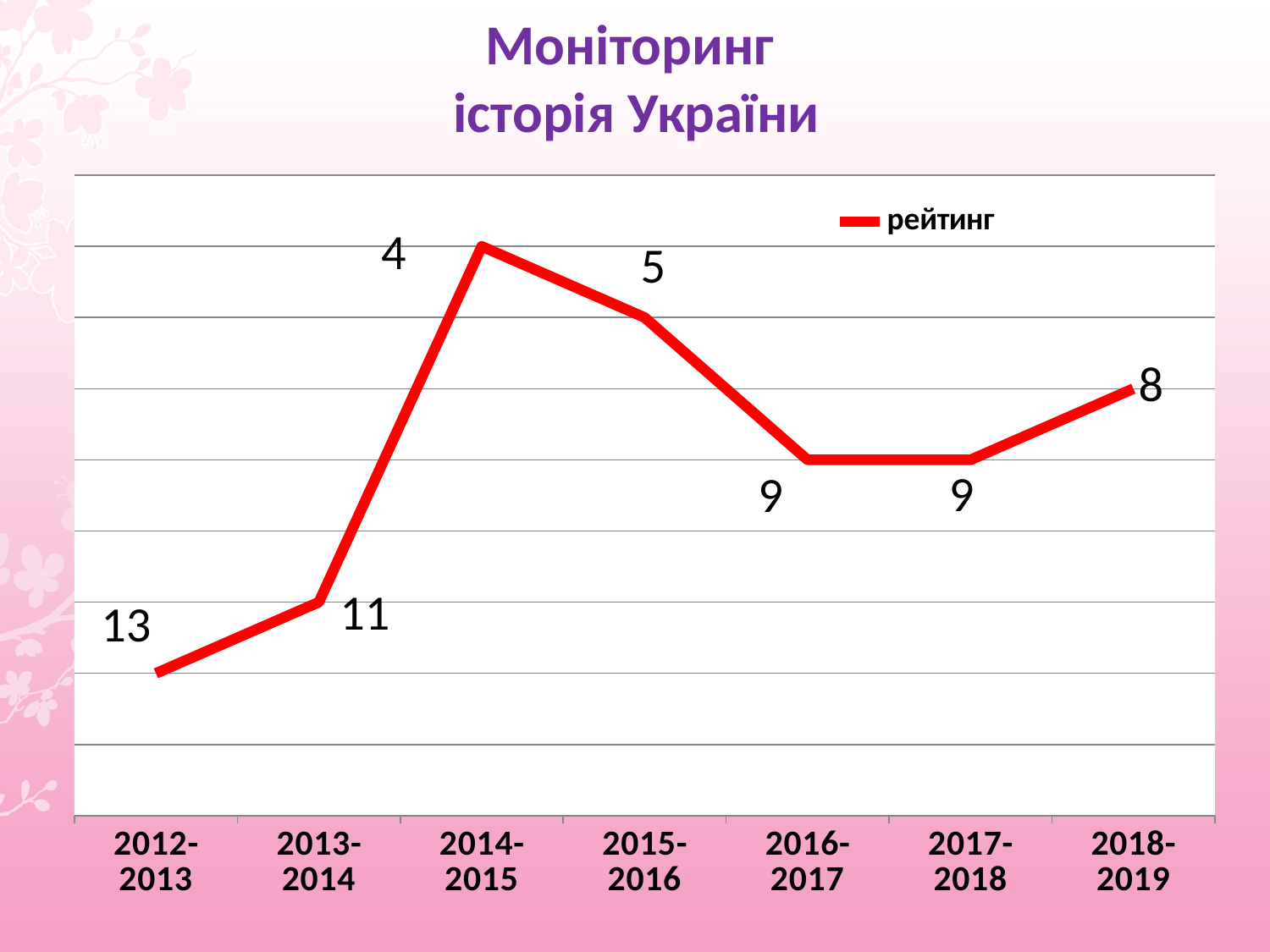
What kind of chart is shown? line chart How many periods are plotted on the x axis? 7 What is the name of the series in the legend? рейтинг What is the difference between the values for 2015-2016 and 2014-2015? 1 What is the value for 2012-2013? 13 What is the value for 2016-2017? 9 What is the difference between the values for 2012-2013 and 2013-2014? 2 What is the value for 2014-2015? 4 What is the value for 2018-2019? 8